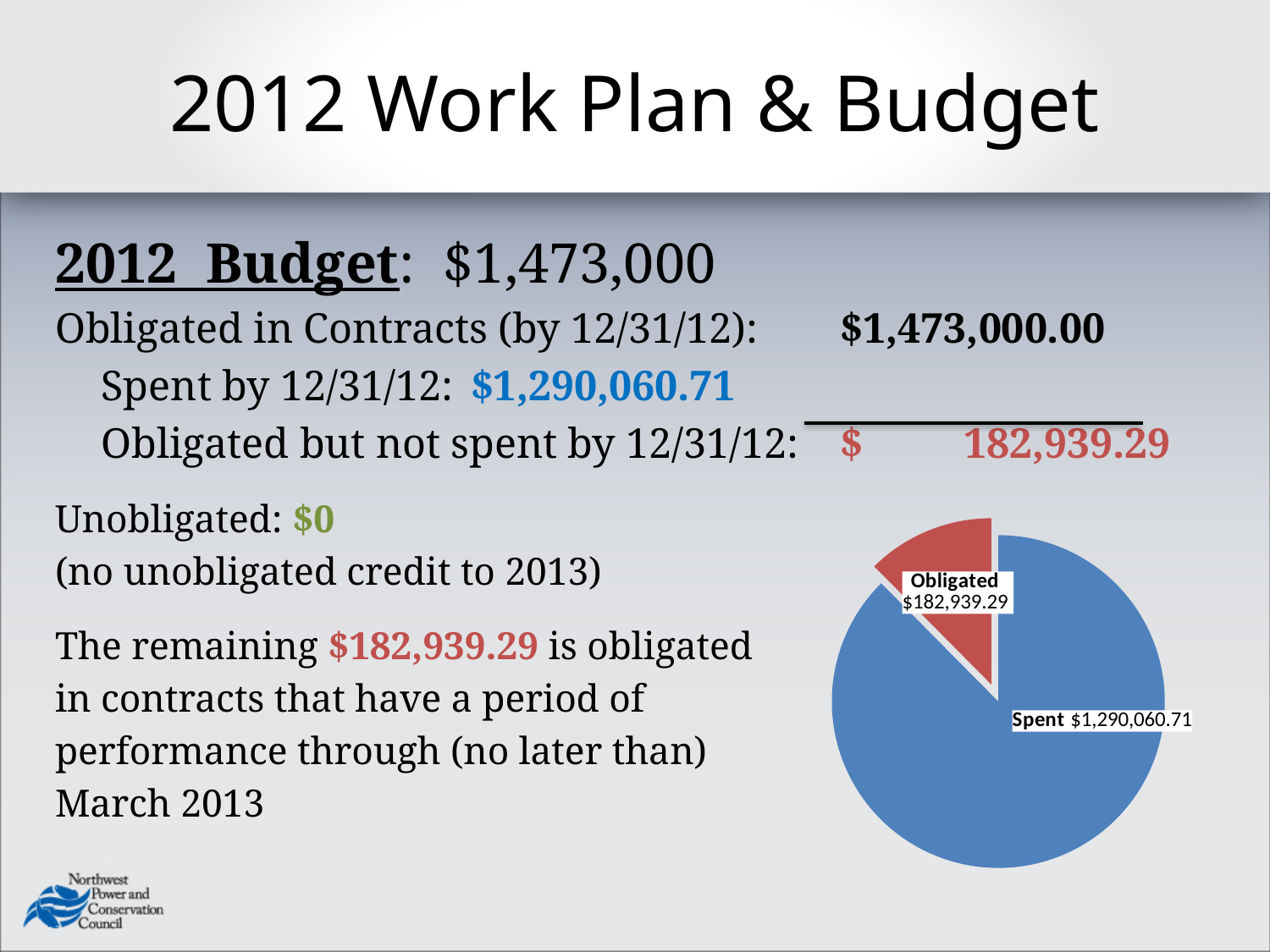
What kind of chart is shown on the slide? Pie chart What colour is the Obligated slice in the pie chart? Red What is the total of the two slices in the pie chart? $1,473,000.00 Which slice of the pie chart is the smallest? Obligated What colour is the Spent slice in the pie chart? Blue Which is larger in the pie chart, Spent or Obligated? Spent Which slice of the pie chart is the largest? Spent How many slices does the pie chart have? 2 What is the value of the Spent slice in the pie chart? $1,290,060.71 What is the value of the Obligated slice in the pie chart? $182,939.29 What is the difference between the Spent and Obligated values in the pie chart? $1,107,121.42